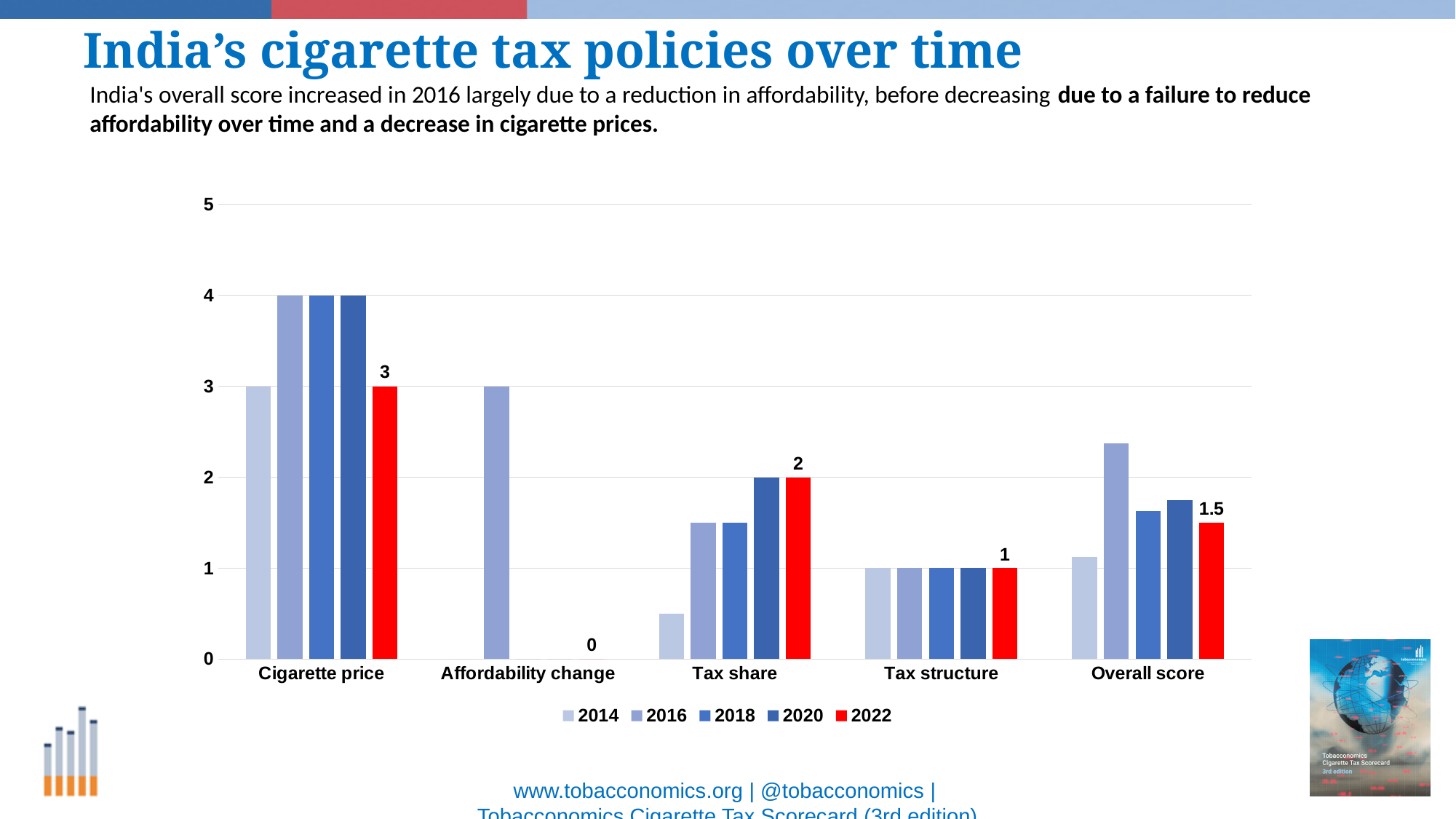
How many categories are shown on the x axis? 5 In 2022, which is larger: Tax share or Tax structure? Tax share Which category has the highest value in 2022? Cigarette price What is the value for Affordability change in 2022? 0 What is the value for Cigarette price in 2022? 3 What is the value for Tax share in 2022? 2 What kind of chart is shown on the slide? bar chart How many series does the legend list? 5 What is the difference between the 2022 values for Cigarette price and Tax share? 1 What is the value for Overall score in 2022? 1.5 Is the value for Overall score in 2016 greater or less than 2? greater Which category has the lowest value in 2022? Affordability change